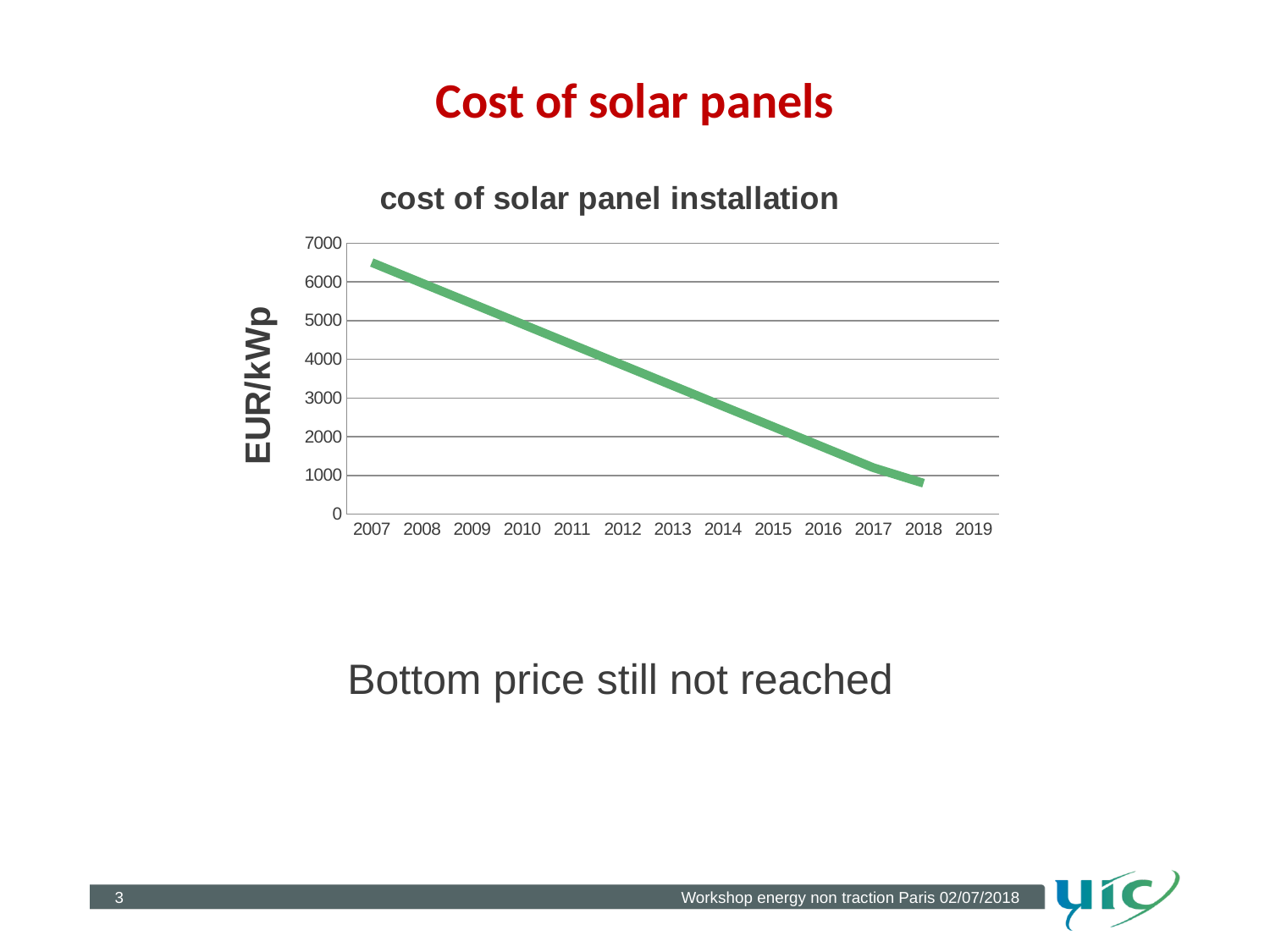
Is the value for 2013 greater or less than 3000? greater Which year has the larger value, 2008 or 2016? 2008 Which year has the lowest cost on the chart? 2018 Do the values rise or fall from 2007 to 2018? fall Is the value for 2009 greater or less than 5000? greater Which year has the highest cost on the chart? 2007 What is the title of the chart? cost of solar panel installation Is the value for 2007 greater or less than 6000? greater What is the label on the vertical axis of the chart? EUR/kWp What kind of chart is shown on the slide? line chart How many year labels are shown on the horizontal axis? 13